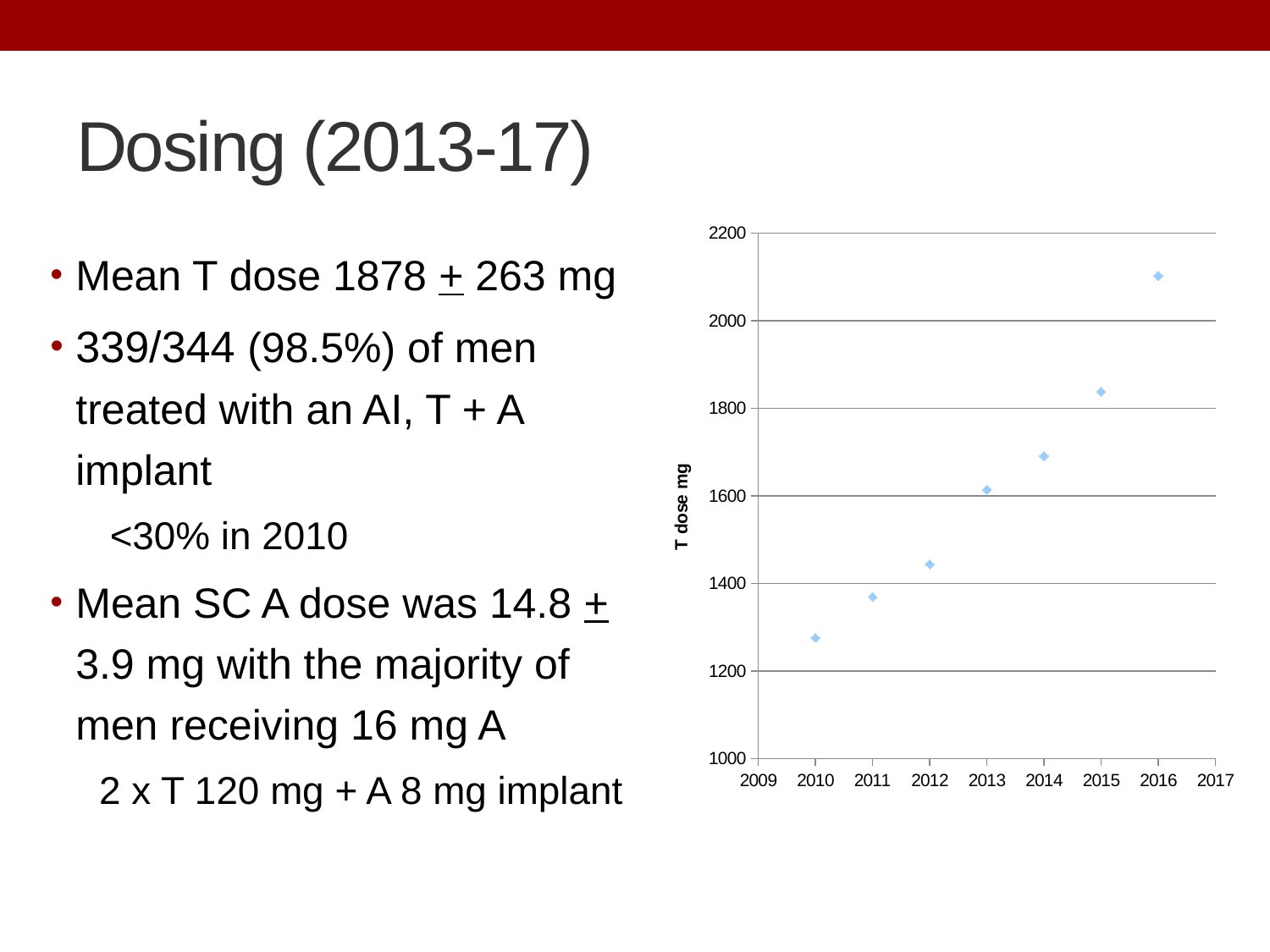
Is the value for 2015 greater or less than 1800? greater Do the T dose values rise or fall from 2010 to 2016? rise Is the value for 2014 greater or less than 1800? less What is the label on the vertical axis of the chart? T dose mg How many data points are plotted on the chart? 7 Which year has the lowest T dose on the chart? 2010 Is the value for 2010 greater or less than 1400? less What kind of chart is shown on the slide? scatter chart Which year has the larger T dose, 2012 or 2015? 2015 Which year has the highest T dose on the chart? 2016